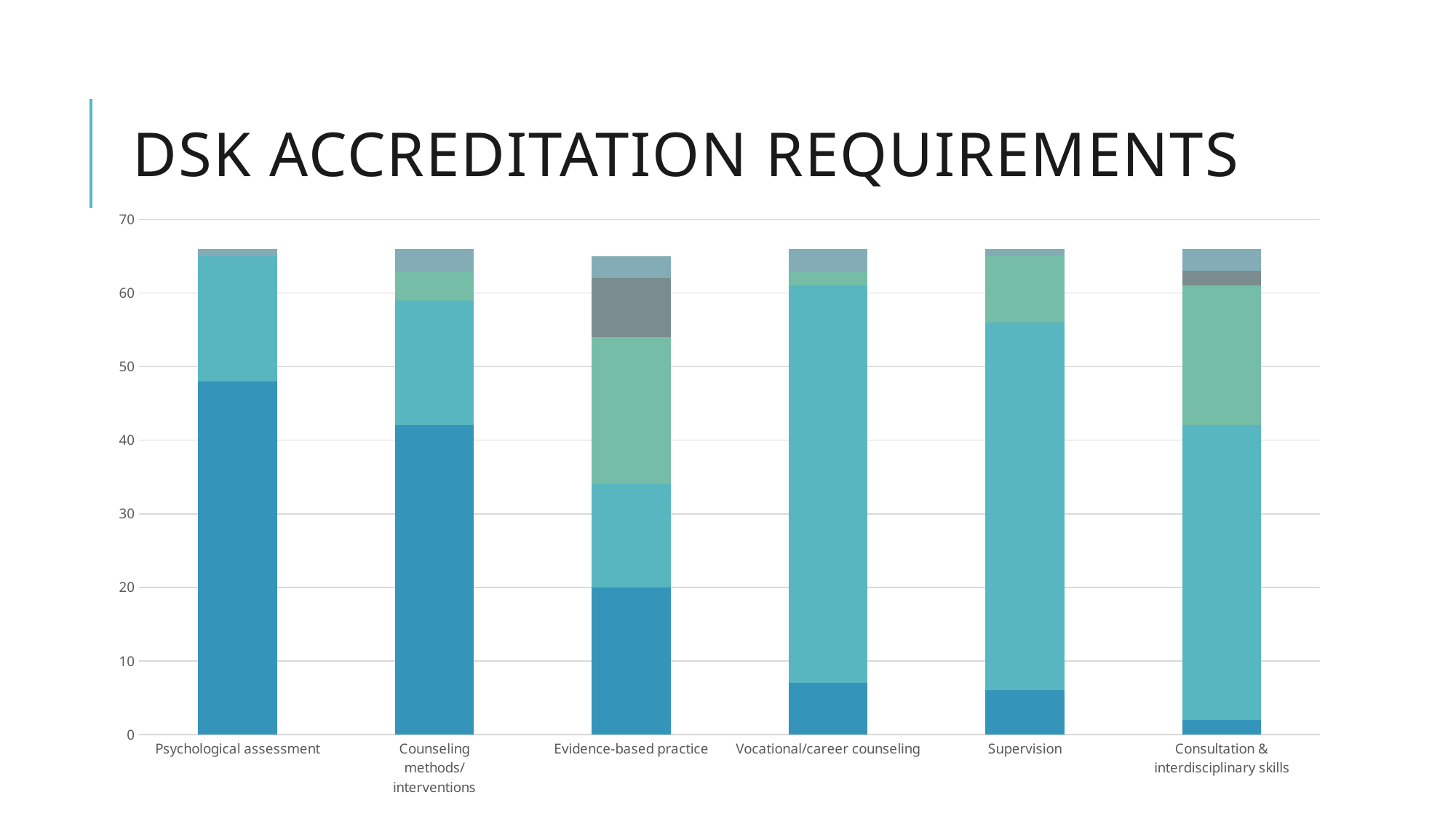
Is the total height of the Supervision bar greater or less than 60? greater Which category has the largest bottom (darkest blue) segment? Psychological assessment Which category has the smallest bottom (darkest blue) segment? Consultation & interdisciplinary skills Is the bottom (darkest blue) segment for Vocational/career counseling greater or less than 10? less What kind of chart is shown on the slide? Stacked bar chart Does the bottom (darkest blue) segment rise or fall moving from left to right across the categories? fall Is the bottom (darkest blue) segment for Psychological assessment greater or less than 40? greater Which has the larger bottom (darkest blue) segment, Psychological assessment or Evidence-based practice? Psychological assessment How many categories are shown along the x axis of the chart? 6 What is the title of the chart on the slide? DSK ACCREDITATION REQUIREMENTS